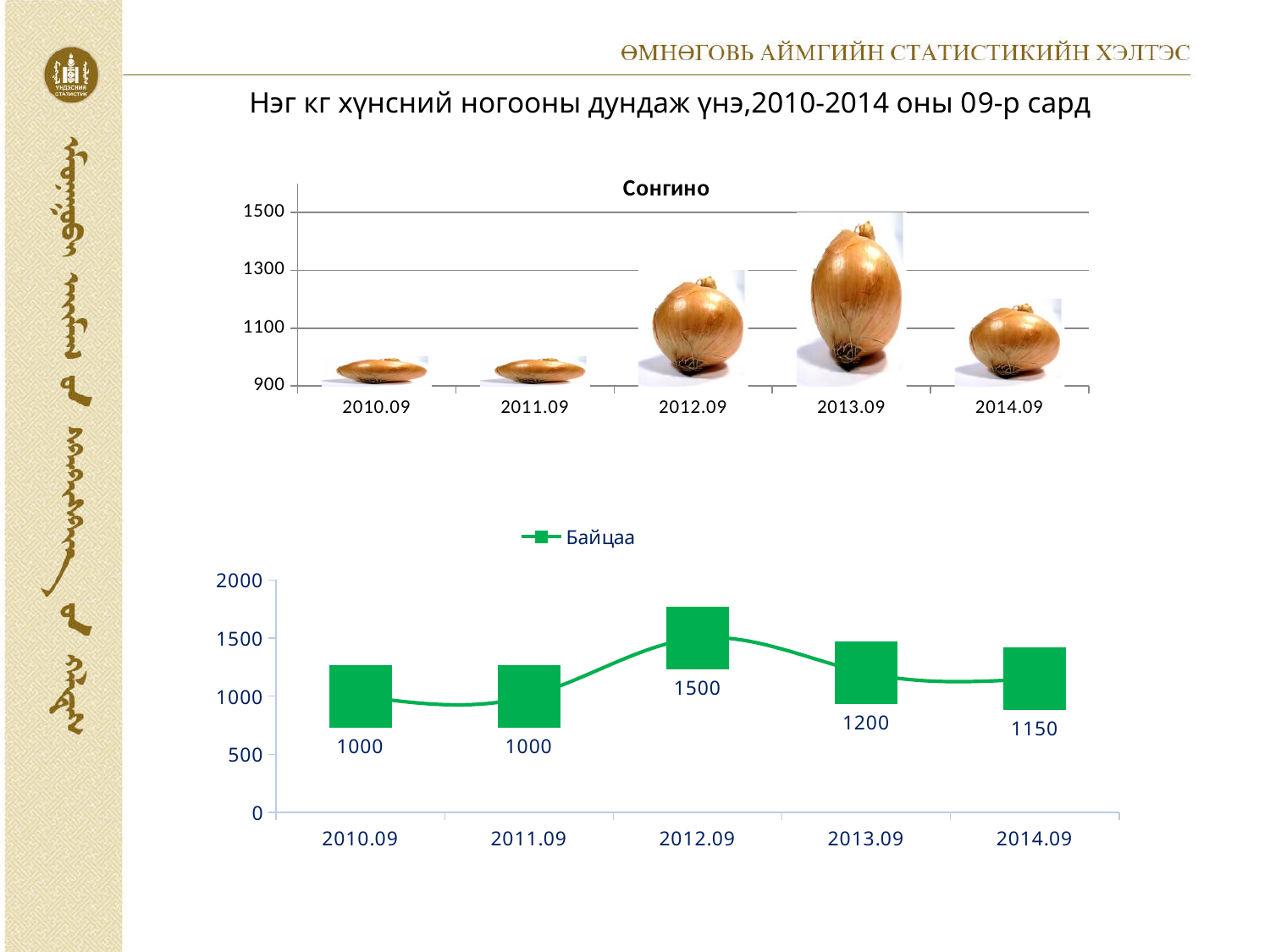
In the top chart (Сонгино), which period has the highest value? 2013.09 In the bottom chart (Байцаа), which period has the highest value? 2012.09 In the bottom chart (Байцаа), how many data points are plotted? 5 In the bottom chart (Байцаа), do the values rise or fall from 2012.09 to 2014.09? fall In the bottom chart (Байцаа), what is the difference between the values for 2013.09 and 2014.09? 50 In the bottom chart (Байцаа), what is the value for 2012.09? 1500 In the bottom chart (Байцаа), which is larger, the value for 2013.09 or the value for 2014.09? 2013.09 In the bottom chart, how many series does the legend list? 1 In the bottom chart (Байцаа), what is the value for 2014.09? 1150 In the top chart (Сонгино), is the value for 2013.09 greater or less than 1300? greater In the bottom chart (Байцаа), what is the difference between the values for 2012.09 and 2011.09? 500 In the bottom chart (Байцаа), what is the value for 2013.09? 1200